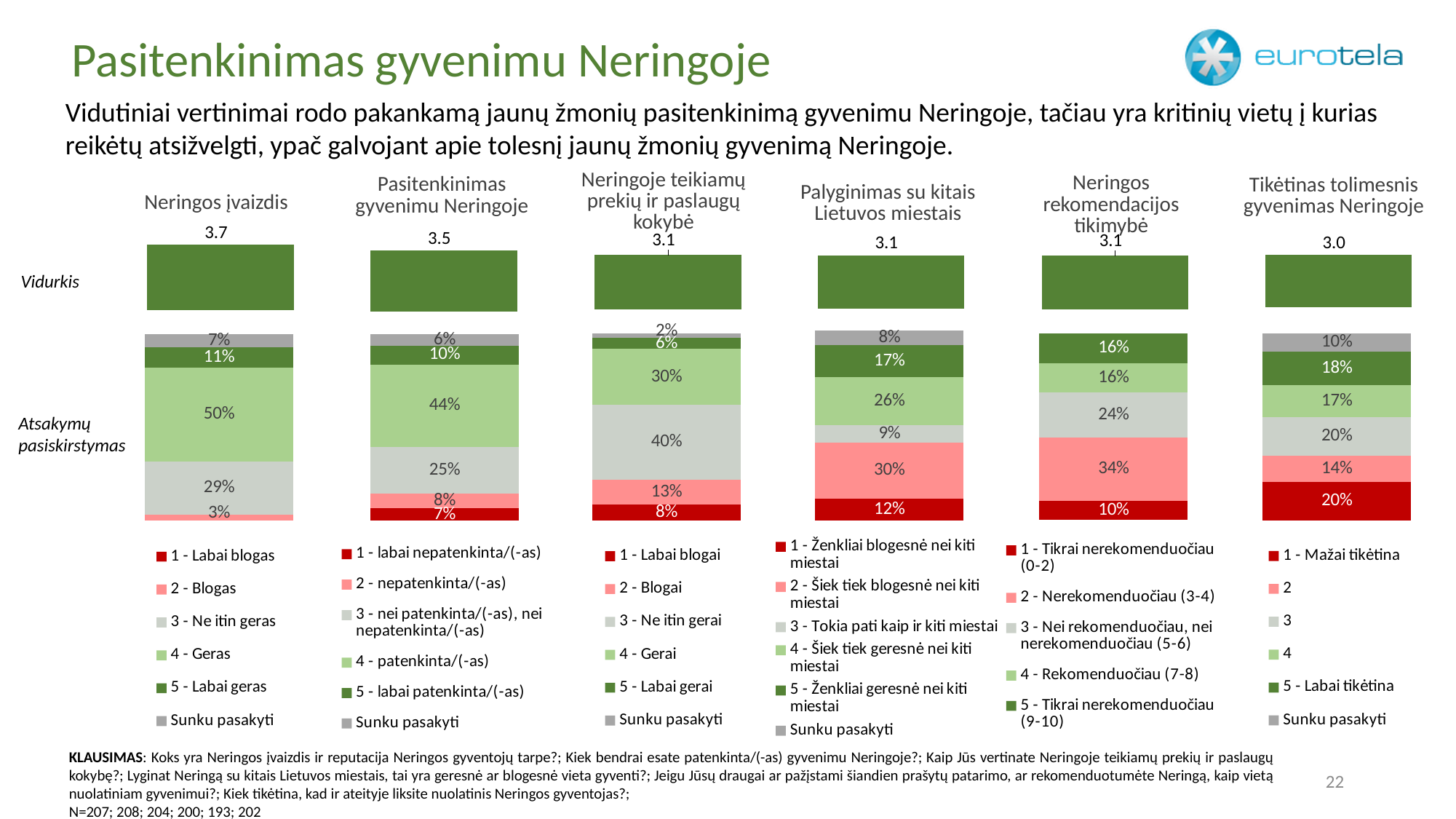
Across the six charts, which one has the highest average (Vidurkis) value? Neringos įvaizdis Across the six charts, which one has the lowest average (Vidurkis) value? Tikėtinas tolimesnis gyvenimas Neringoje How many charts (topics) are shown on the slide? 6 In the 'Palyginimas su kitais Lietuvos miestais' chart, what is the difference between the share for '2 - Šiek tiek blogesnė nei kiti miestai' and '1 - Ženkliai blogesnė nei kiti miestai'? 18% In the 'Tikėtinas tolimesnis gyvenimas Neringoje' chart, what percentage of respondents answered '1 - Mažai tikėtina'? 20% In the 'Neringos įvaizdis' chart, which is larger: the share for '4 - Geras' or '3 - Ne itin geras'? 4 - Geras In the 'Neringoje teikiamų prekių ir paslaugų kokybė' chart, what percentage answered '3 - Ne itin gerai'? 40% In the 'Neringos įvaizdis' chart, what is the average (Vidurkis) value shown? 3.7 How many legend entries does the 'Neringos įvaizdis' chart list? 6 What type of chart is used to show the 'Atsakymų pasiskirstymas' (response distribution) on the slide? Stacked bar chart In the 'Neringos rekomendacijos tikimybė' chart, what percentage of respondents answered '2 - Nerekomenduočiau (3-4)'? 34% In the 'Pasitenkinimas gyvenimu Neringoje' chart, which response category has the largest share? 4 - patenkinta/(-as)